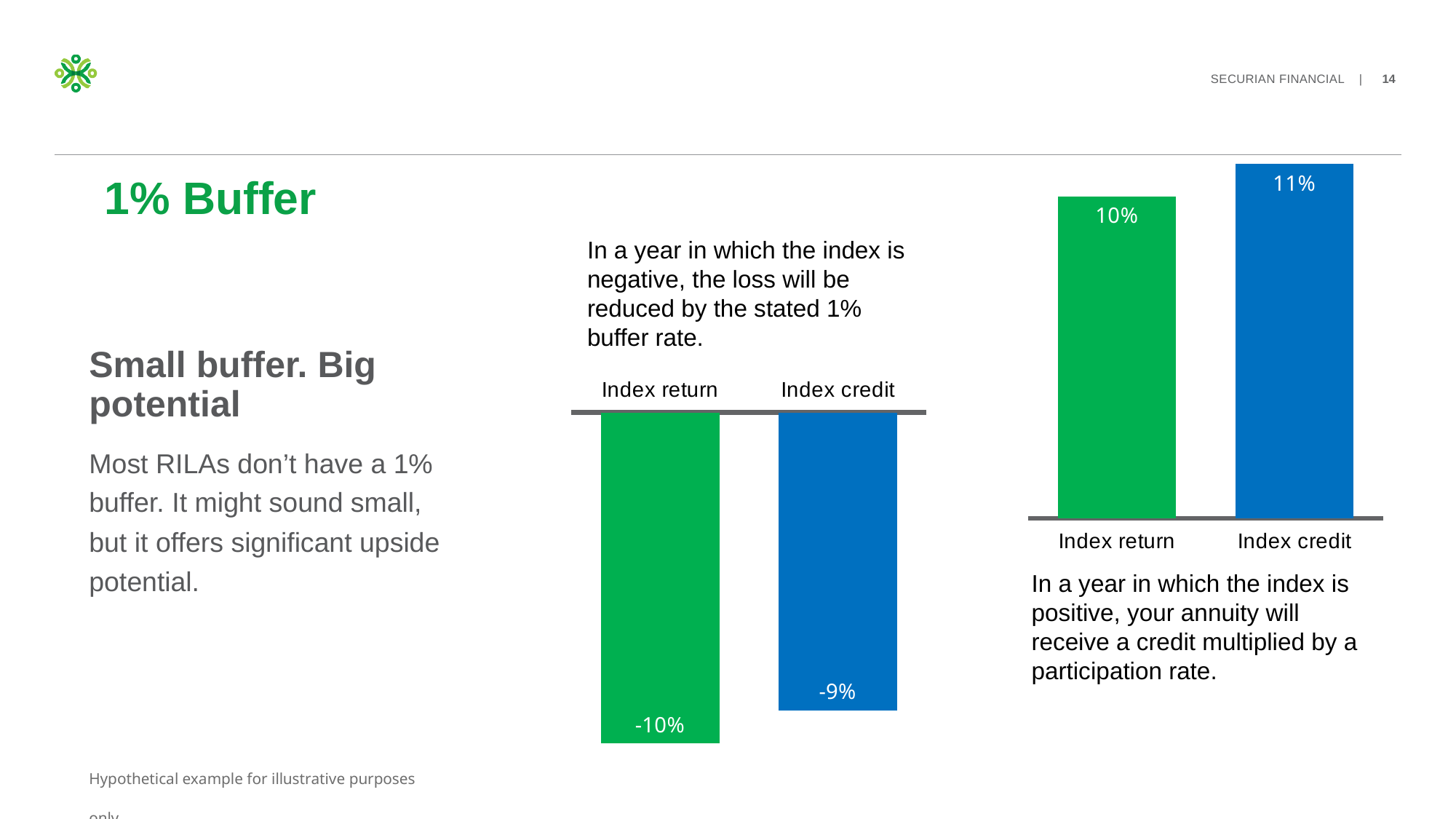
In the left chart (negative index year), what is the value for Index return? -10% In the right chart (positive index year), what is the value for Index credit? 11% How many bars are in the right chart (positive index year)? 2 In the right chart (positive index year), which category has the higher value? Index credit In the right chart (positive index year), what colour is the Index credit bar? blue In the left chart (negative index year), is Index credit larger or smaller than Index return? larger In the left chart (negative index year), which category has the lower value? Index return In the right chart (positive index year), what is the value for Index return? 10% In the right chart (positive index year), what is the difference between Index credit and Index return? 1% What type of chart is the left chart (negative index year)? bar chart In the left chart (negative index year), what is the difference between Index credit and Index return? 1% In the left chart (negative index year), what is the value for Index credit? -9%